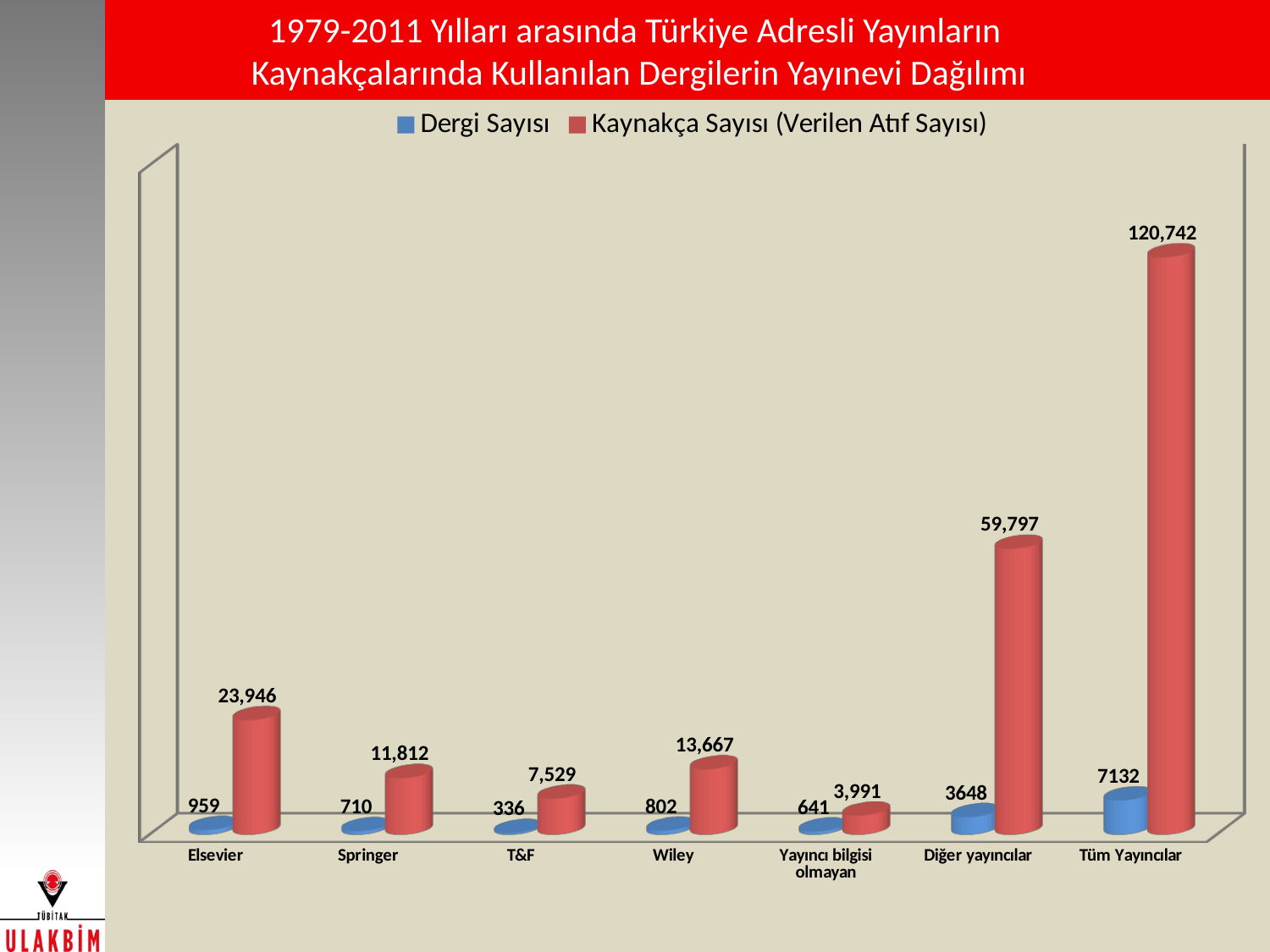
What kind of chart is shown on the slide? Bar chart What is the Dergi Sayısı value for Tüm Yayıncılar? 7132 Which category has the highest Kaynakça Sayısı (Verilen Atıf Sayısı) value? Tüm Yayıncılar How many series does the legend list? 2 What is the difference between the Kaynakça Sayısı values for Elsevier and Springer? 12,134 Which has a larger Kaynakça Sayısı (Verilen Atıf Sayısı) value, Wiley or Springer? Wiley What is the Kaynakça Sayısı (Verilen Atıf Sayısı) value for Diğer yayıncılar? 59,797 What is the Dergi Sayısı value for T&F? 336 Which category has the lowest Dergi Sayısı value? T&F Which colour represents the Dergi Sayısı series? Blue What is the Kaynakça Sayısı (Verilen Atıf Sayısı) value for Elsevier? 23,946 How many categories are shown on the x axis? 7